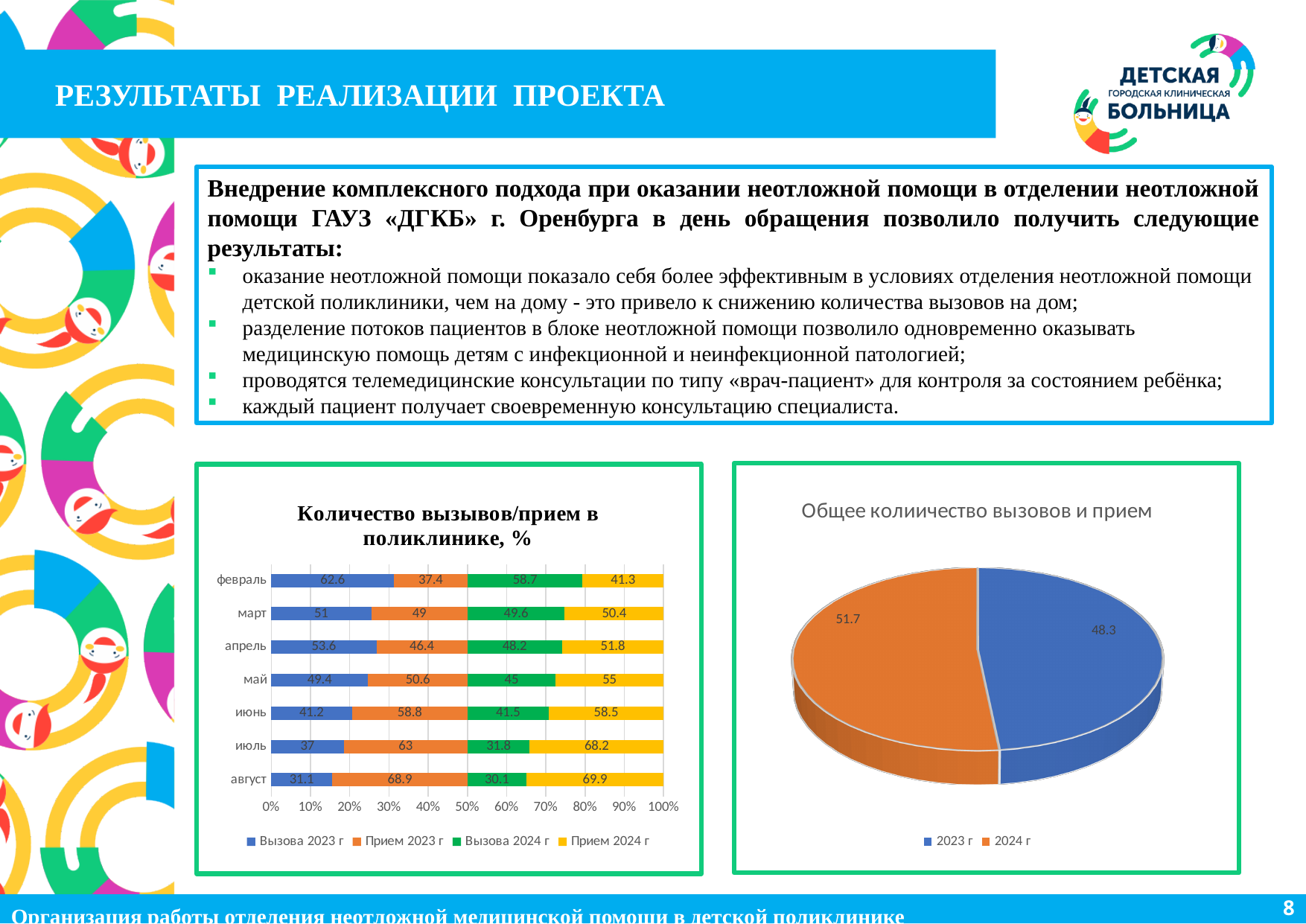
In the chart "Количество вызывов/прием в поликлинике, %", which month has the highest value for Вызова 2023 г? февраль In the chart "Количество вызывов/прием в поликлинике, %", how many months are shown? 7 In the chart "Количество вызывов/прием в поликлинике, %", what is the difference between Прием 2023 г and Вызова 2023 г in июль? 26 What kind of chart is "Общее колиичество вызовов и прием"? Pie chart In the chart "Количество вызывов/прием в поликлинике, %", what is the value for Вызова 2024 г in июль? 31.8 In the chart "Количество вызывов/прием в поликлинике, %", how do the values for Вызова 2023 г change from февраль to август? They fall In the chart "Количество вызывов/прием в поликлинике, %", which month has the lowest value for Вызова 2024 г? август In the chart "Количество вызывов/прием в поликлинике, %", how many series does the legend list? 4 In the chart "Количество вызывов/прием в поликлинике, %", which is larger in май: Вызова 2024 г or Прием 2024 г? Прием 2024 г In the chart "Количество вызывов/прием в поликлинике, %", what is the value for Прием 2024 г in август? 69.9 In the chart "Количество вызывов/прием в поликлинике, %", what is the value for Вызова 2023 г in февраль? 62.6 In the chart "Общее колиичество вызовов и прием", what is the value for 2024 г? 51.7